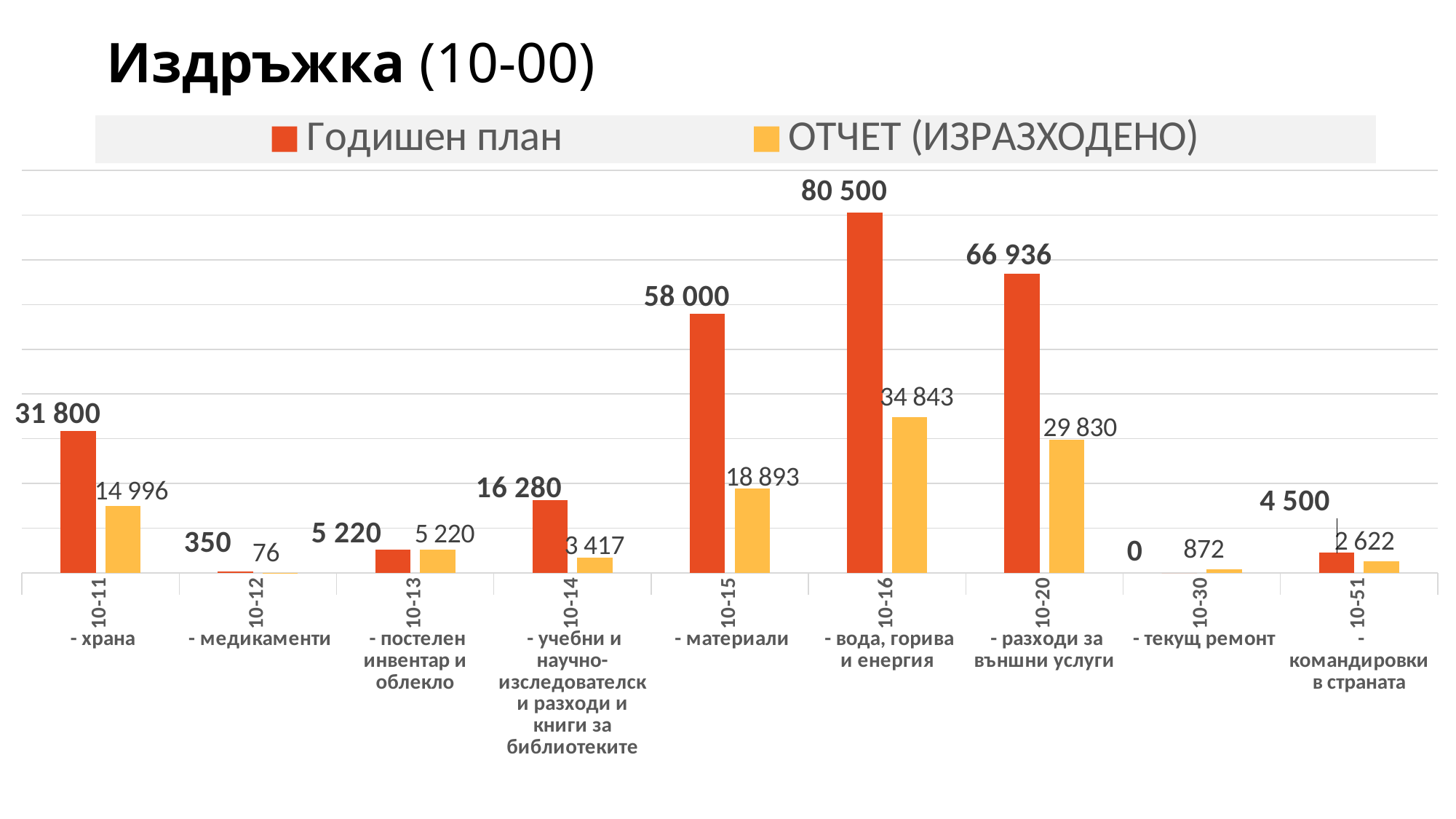
What is the title of the slide? Издръжка (10-00) What is the Годишен план value for 10-13 (постелен инвентар и облекло)? 5 220 Which is larger for 10-30 (текущ ремонт): the Годишен план value or the ОТЧЕТ (ИЗРАЗХОДЕНО) value? ОТЧЕТ (ИЗРАЗХОДЕНО) What is the Годишен план value for 10-16 (вода, горива и енергия)? 80 500 Which category has the highest Годишен план value? 10-16 (вода, горива и енергия) What is the difference between the Годишен план and ОТЧЕТ (ИЗРАЗХОДЕНО) values for 10-15 (материали)? 39 107 How many series does the legend list? 2 How many categories are shown on the x axis? 9 What kind of chart is shown on the slide? Bar chart What is the ОТЧЕТ (ИЗРАЗХОДЕНО) value for 10-20 (разходи за външни услуги)? 29 830 Which category has the lowest ОТЧЕТ (ИЗРАЗХОДЕНО) value? 10-12 (медикаменти) What is the ОТЧЕТ (ИЗРАЗХОДЕНО) value for 10-11 (храна)? 14 996